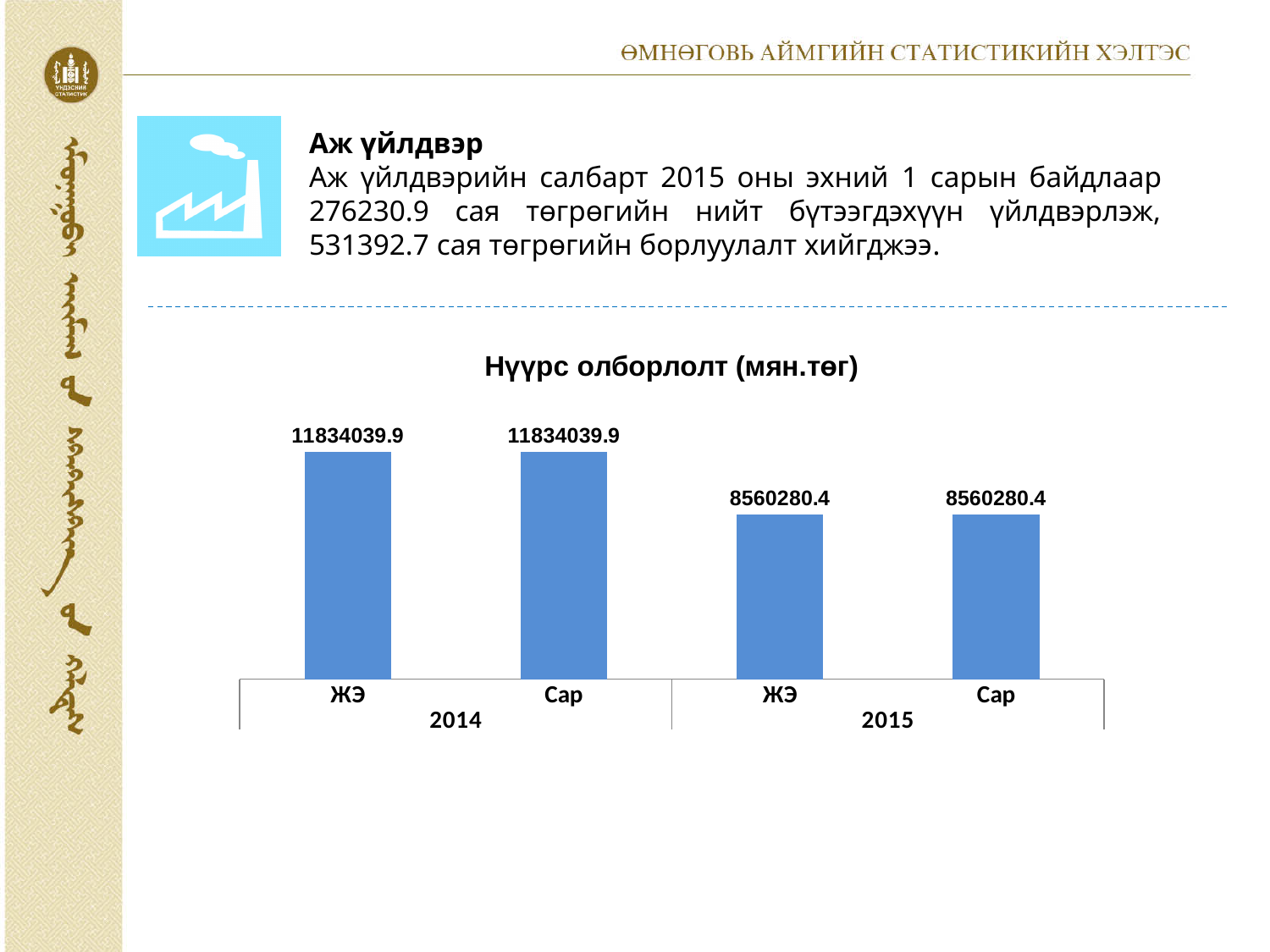
What colour are the bars in the chart? blue What is the value for Сар in 2014? 11834039.9 What is the value for Сар in 2015? 8560280.4 What is the difference between the value for ЖЭ in 2014 and the value for ЖЭ in 2015? 3273759.5 What is the title of the chart? Нүүрс олборлолт (мян.төг) What is the value for ЖЭ in 2015? 8560280.4 What is the value for ЖЭ in 2014? 11834039.9 What type of chart is shown on the slide? bar chart How many bars are plotted in the chart? 4 Which is larger, the value for ЖЭ in 2014 or the value for ЖЭ in 2015? ЖЭ in 2014 Do the values rise or fall from 2014 to 2015? fall Which is larger, the value for Сар in 2015 or the value for Сар in 2014? Сар in 2014